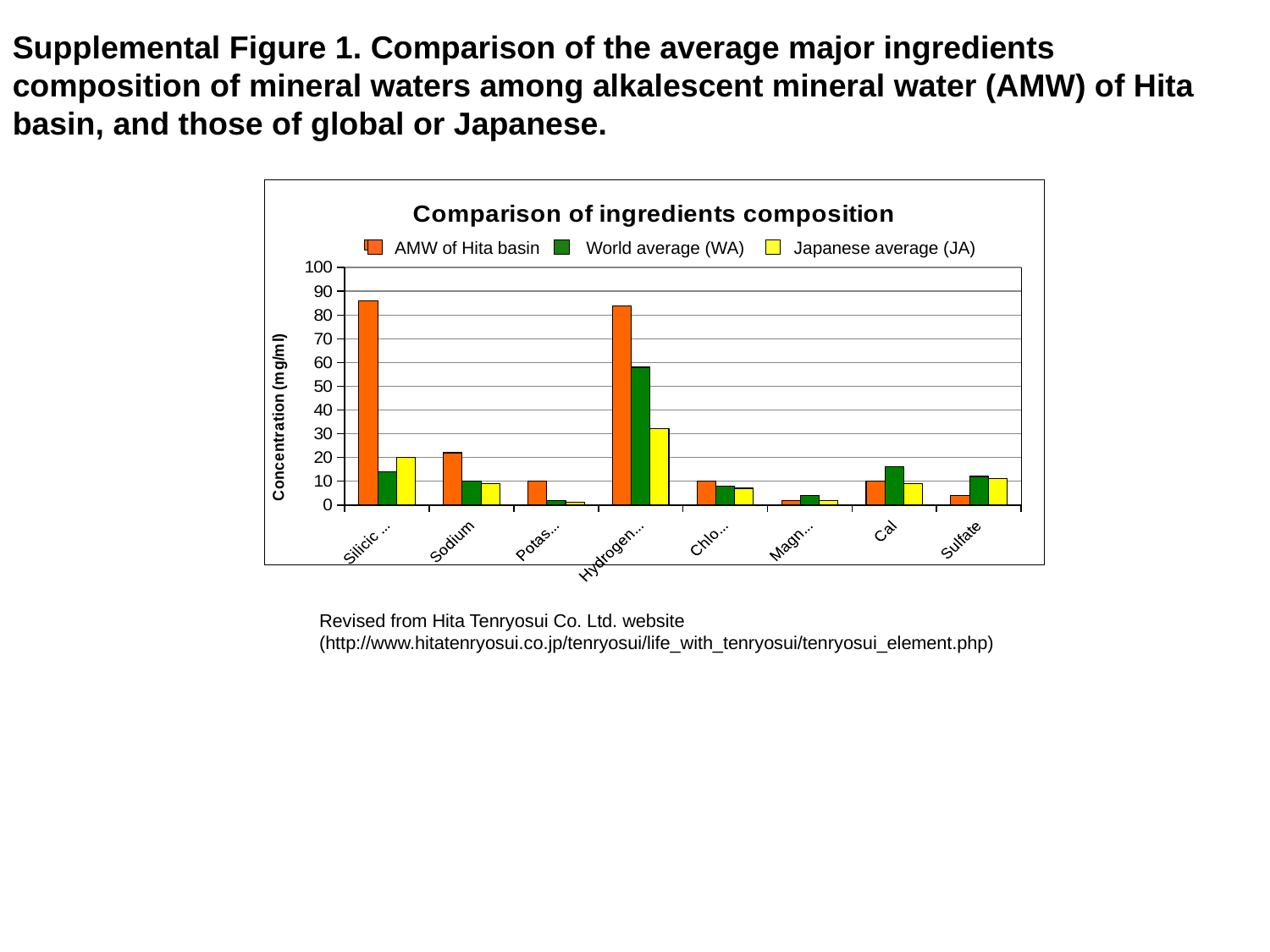
For Cal, which is larger: the AMW of Hita basin value or the World average (WA) value? World average (WA) How many ingredient categories are shown on the x axis? 8 What kind of chart is shown on the slide? bar chart What is the label of the y axis? Concentration (mg/ml) For Sodium, which is larger: the AMW of Hita basin value or the World average (WA) value? AMW of Hita basin Is the World average (WA) value for Hydrogen... greater or less than 50? greater Which category has the highest World average (WA) value? Hydrogen... How many series does the legend list? 3 For Sulfate, which is larger: the AMW of Hita basin value or the World average (WA) value? World average (WA) Is the Japanese average (JA) value for Silicic... greater or less than 30? less Is the AMW of Hita basin value for Silicic... greater or less than 80? greater Which category has the highest Japanese average (JA) value? Hydrogen...